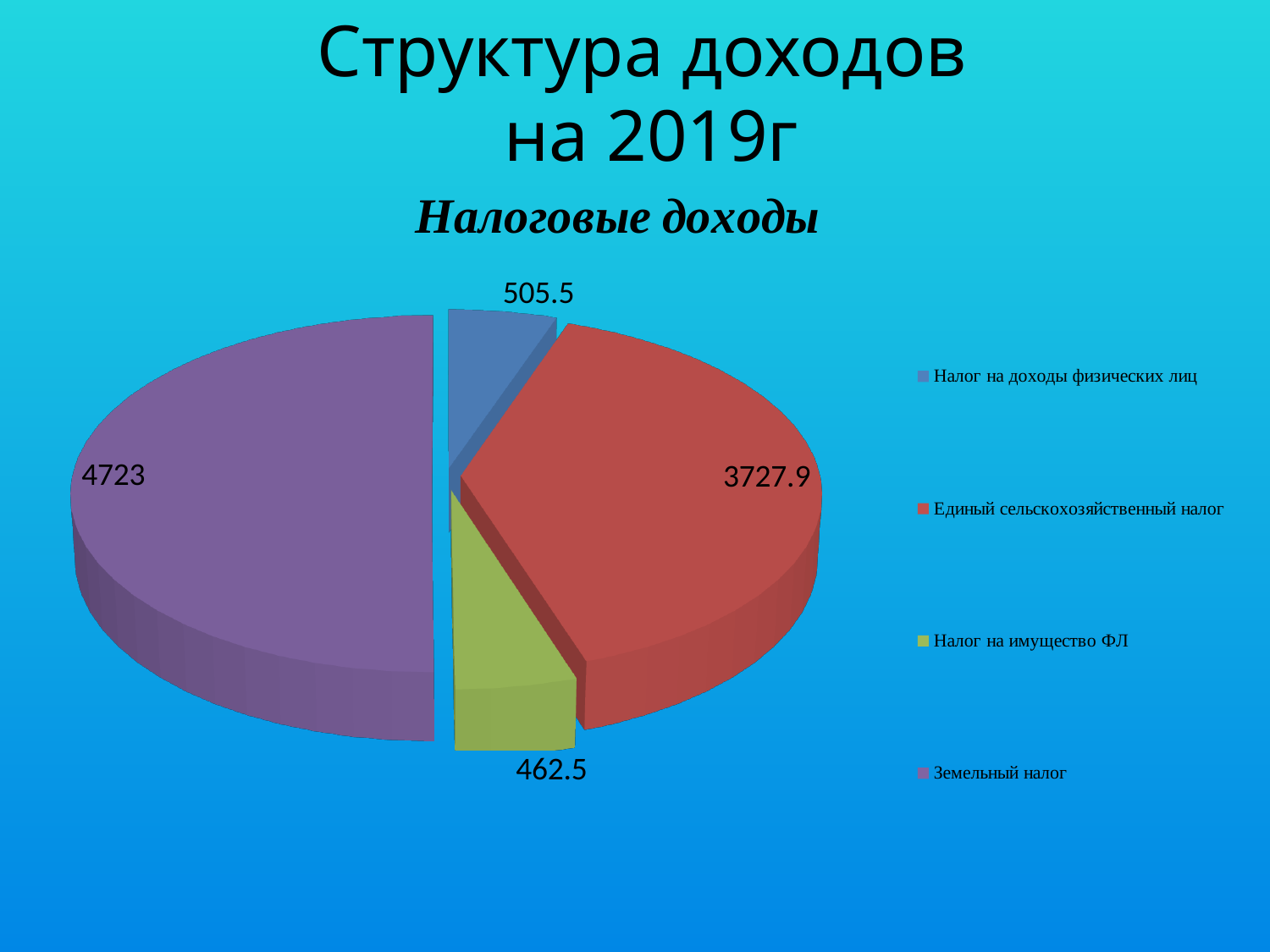
What is the difference between the values for Земельный налог and Единый сельскохозяйственный налог? 995.1 What is the value for Налог на доходы физических лиц? 505.5 What is the value for Единый сельскохозяйственный налог? 3727.9 Which category has the largest slice of the pie? Земельный налог What type of chart is shown on the slide? Pie chart What is the total of all four slices in the pie chart? 9418.9 What is the value for Земельный налог? 4723 What is the subtitle of the chart shown below the slide title? Налоговые доходы What is the value for Налог на имущество ФЛ? 462.5 Which is larger: the value for Налог на доходы физических лиц or the value for Налог на имущество ФЛ? Налог на доходы физических лиц Which category has the smallest slice of the pie? Налог на имущество ФЛ How many categories does the pie chart show? 4